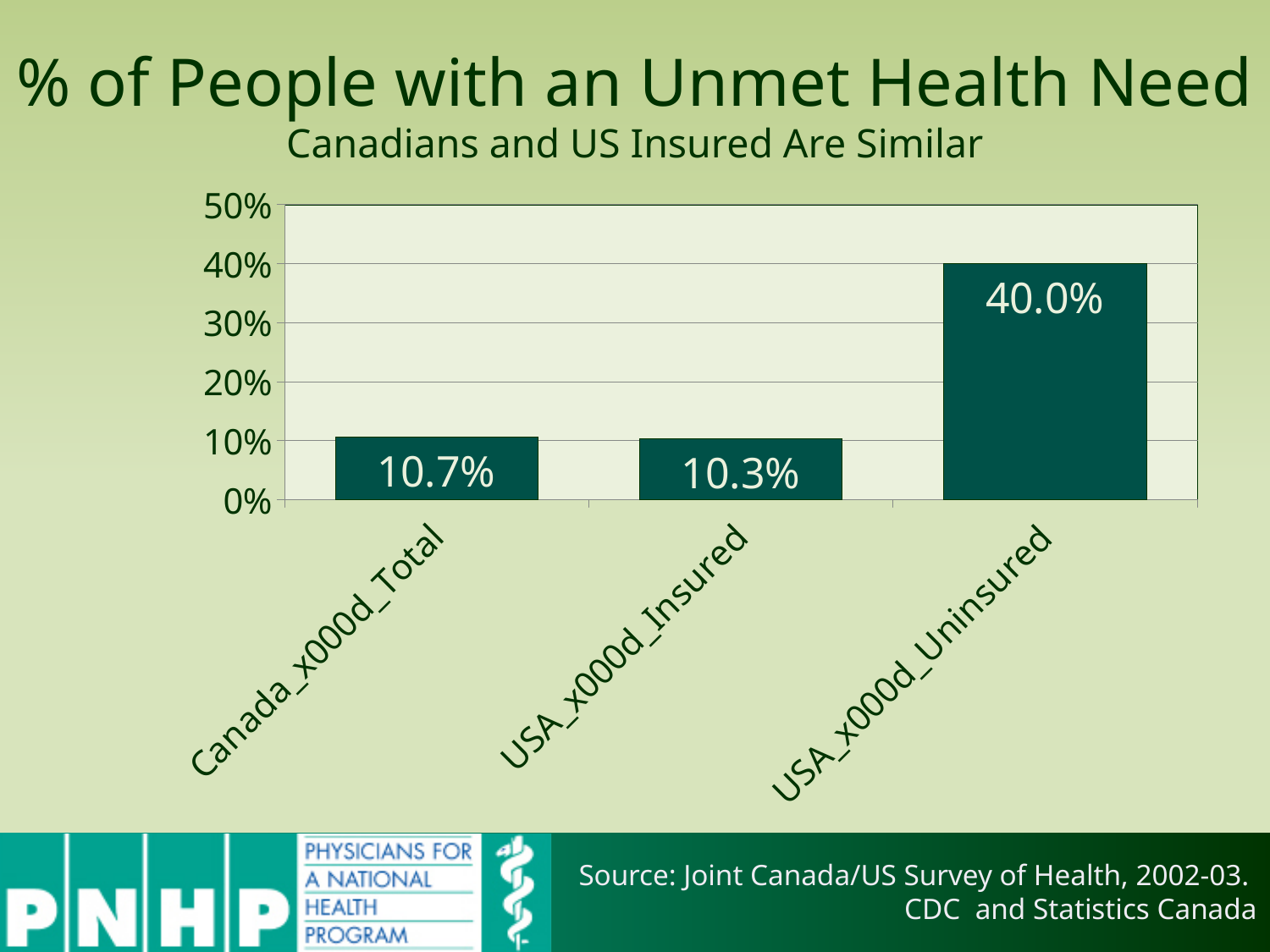
What is the value for USA Insured? 10.3% What is the subtitle of the chart? Canadians and US Insured Are Similar Which category has the lowest value? USA Insured What is the difference between the USA Uninsured and USA Insured values? 29.7% What is the value for USA Uninsured? 40.0% What is the value for Canada Total? 10.7% What kind of chart is shown on the slide? Bar chart Which category has the highest value? USA Uninsured Is the value for USA Uninsured greater or less than 30%? greater Which is larger, the value for Canada Total or the value for USA Insured? Canada Total How many categories are shown in the chart? 3 What is the difference between the USA Uninsured and Canada Total values? 29.3%